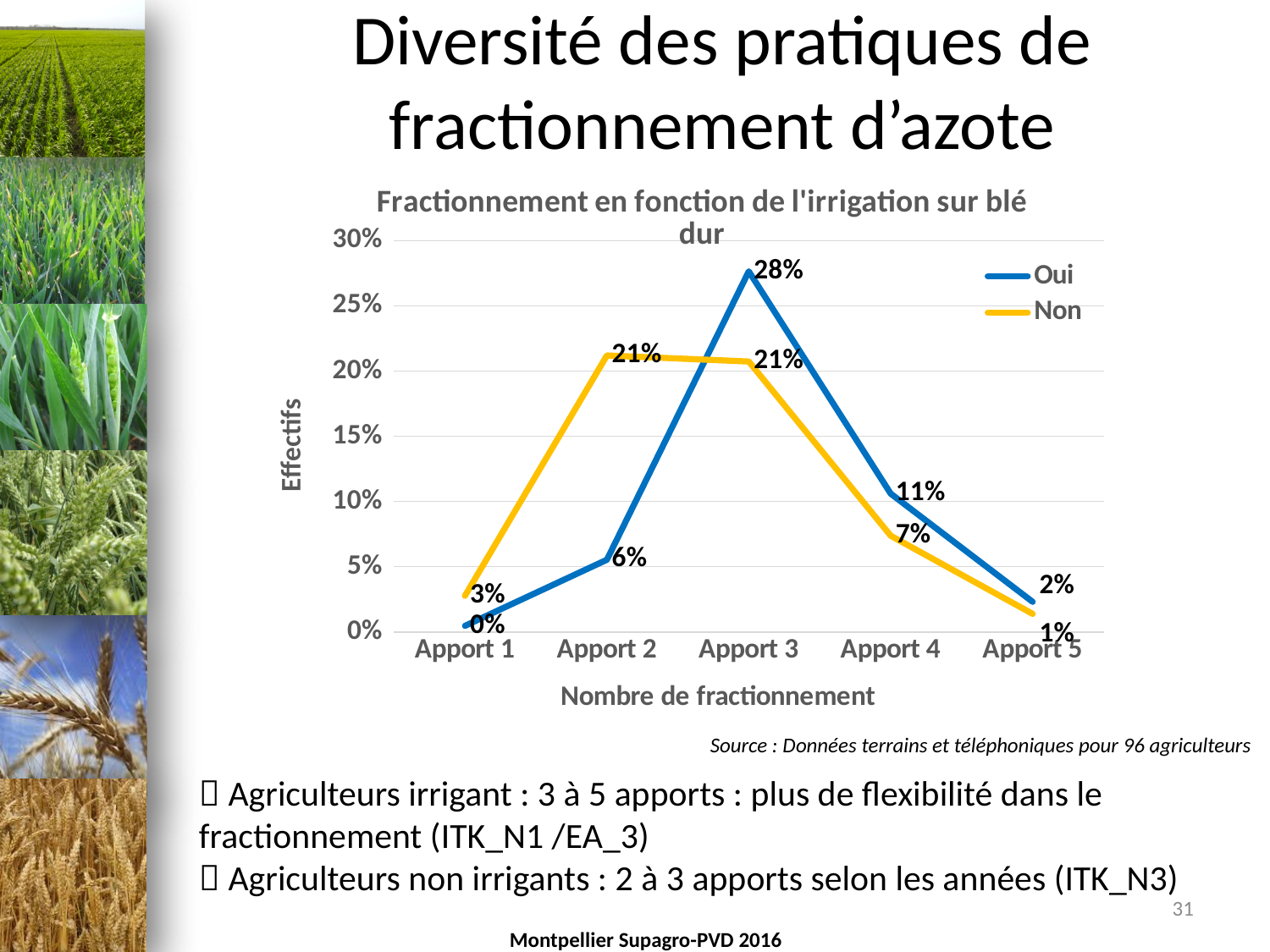
How many categories are shown on the x axis? 5 At which category does the Oui series reach its highest value? Apport 3 What is the value of the Oui series at Apport 3? 28% What is the value of the Non series at Apport 5? 1% What is the difference between the Oui and Non values at Apport 3? 7% What is the value of the Non series at Apport 2? 21% What is the value of the Oui series at Apport 4? 11% What is the title of the chart? Fractionnement en fonction de l'irrigation sur blé dur What type of chart is shown on the slide? line chart How many series does the legend list? 2 At Apport 2, which series has the larger value, Oui or Non? Non At which category is the Non series lowest? Apport 5